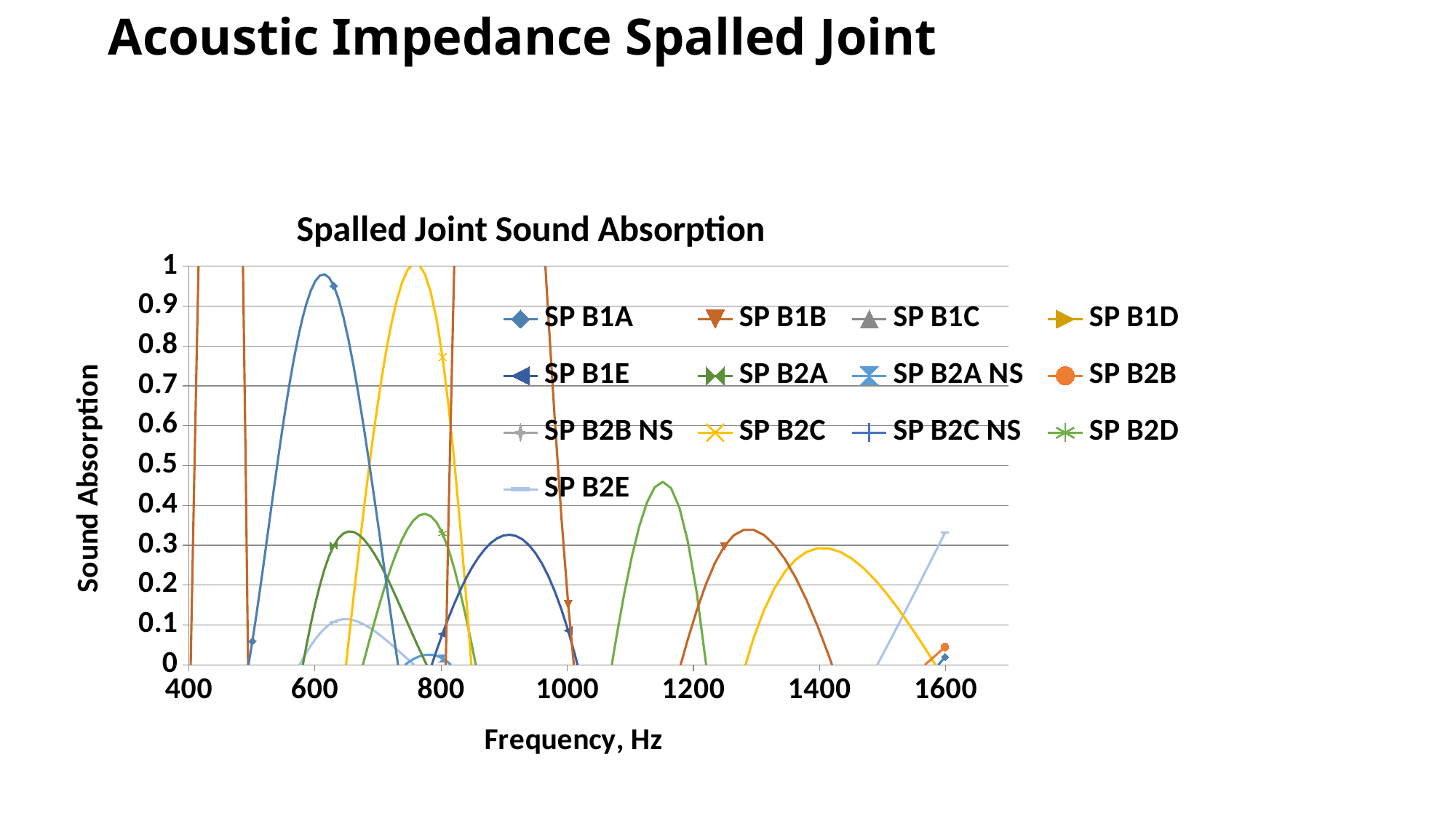
At 800 Hz, which series has the larger value, SP B2C or SP B2D? SP B2C Is the value for SP B2D at 800 Hz greater or less than 0.4? less How many series does the legend list? 13 What kind of chart is shown on the slide? line chart Is the value for SP B2B at 1600 Hz greater or less than 0.1? less Is the value for SP B1B at 1000 Hz greater or less than 0.1? greater What is the label of the x axis? Frequency, Hz What is the title of the chart? Spalled Joint Sound Absorption